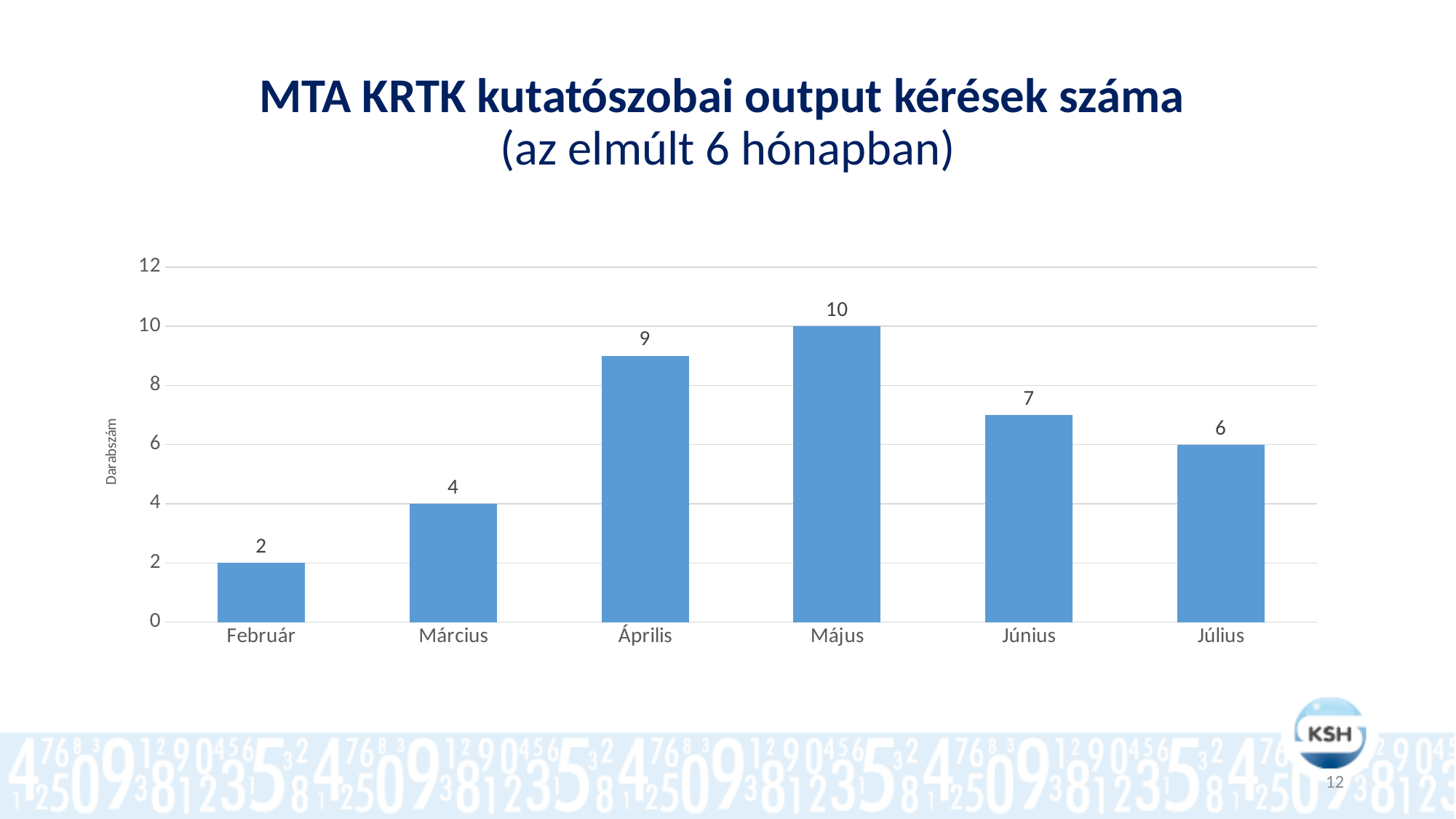
Which month has the highest value? Május What kind of chart is shown on the slide? bar chart How many months are shown on the x axis? 6 What is the difference between the values for Május and Február? 8 Do the values rise or fall from Május to Július? fall Which month has the lowest value? Február What is the value for Május? 10 What is the difference between the values for Április and Július? 3 What is the value for Június? 7 What is the value for Február? 2 What is the label of the vertical axis? Darabszám Which is larger, the value for Március or the value for Július? Július